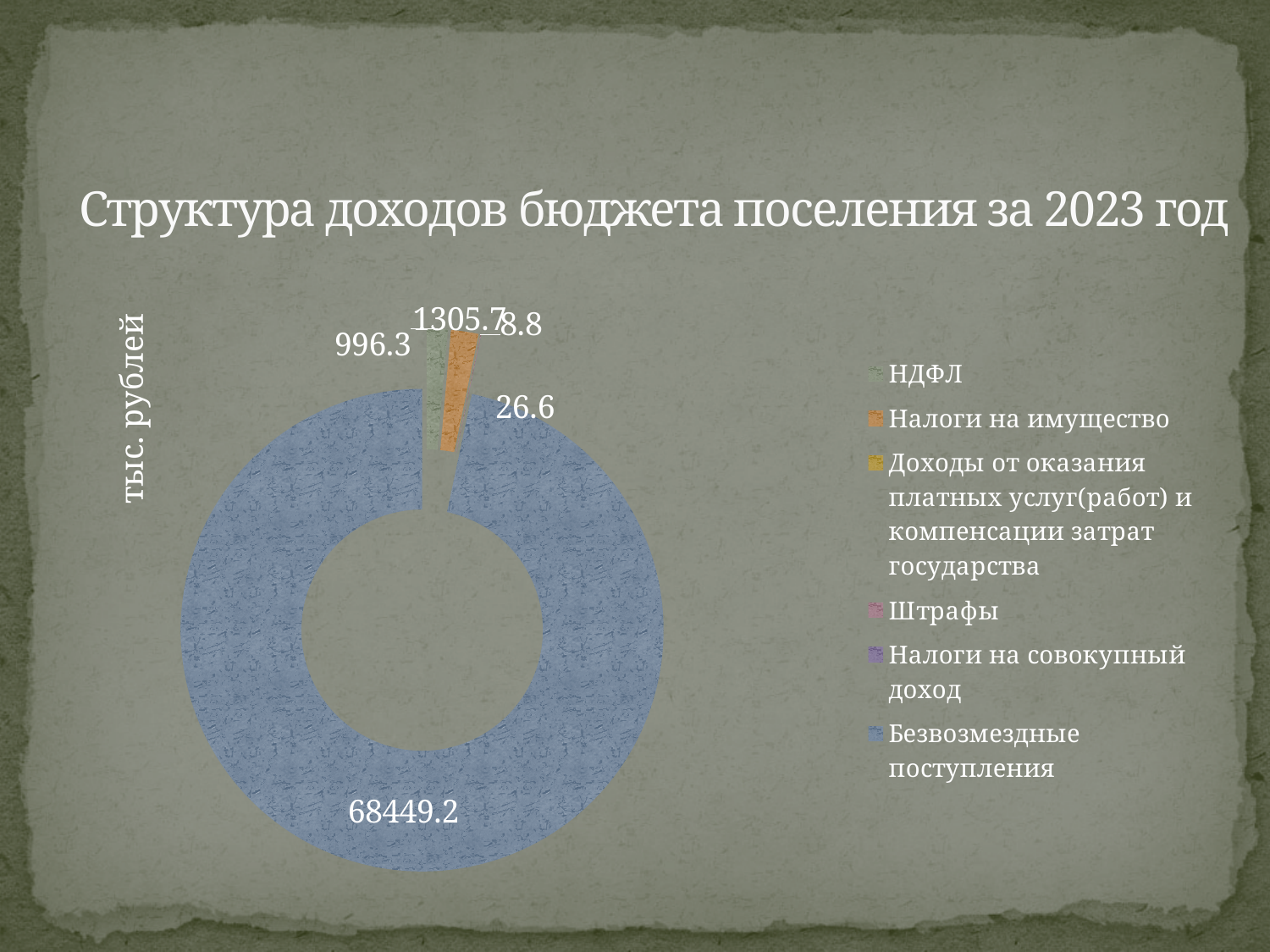
What is the value for Безвозмездные поступления? 68449.2 What is the value for НДФЛ? 996.3 Which category has the largest slice? Безвозмездные поступления What kind of chart is shown on the slide? doughnut (pie) chart What is the title of the chart? Структура доходов бюджета поселения за 2023 год What unit is indicated on the chart's vertical label? тыс. рублей What is the value for Налоги на имущество? 1305.7 Which is larger, НДФЛ or Налоги на имущество? Налоги на имущество Is the value for Безвозмездные поступления greater or less than 50000? greater How many entries does the legend list? 6 What is the difference between Налоги на имущество and НДФЛ? 309.4